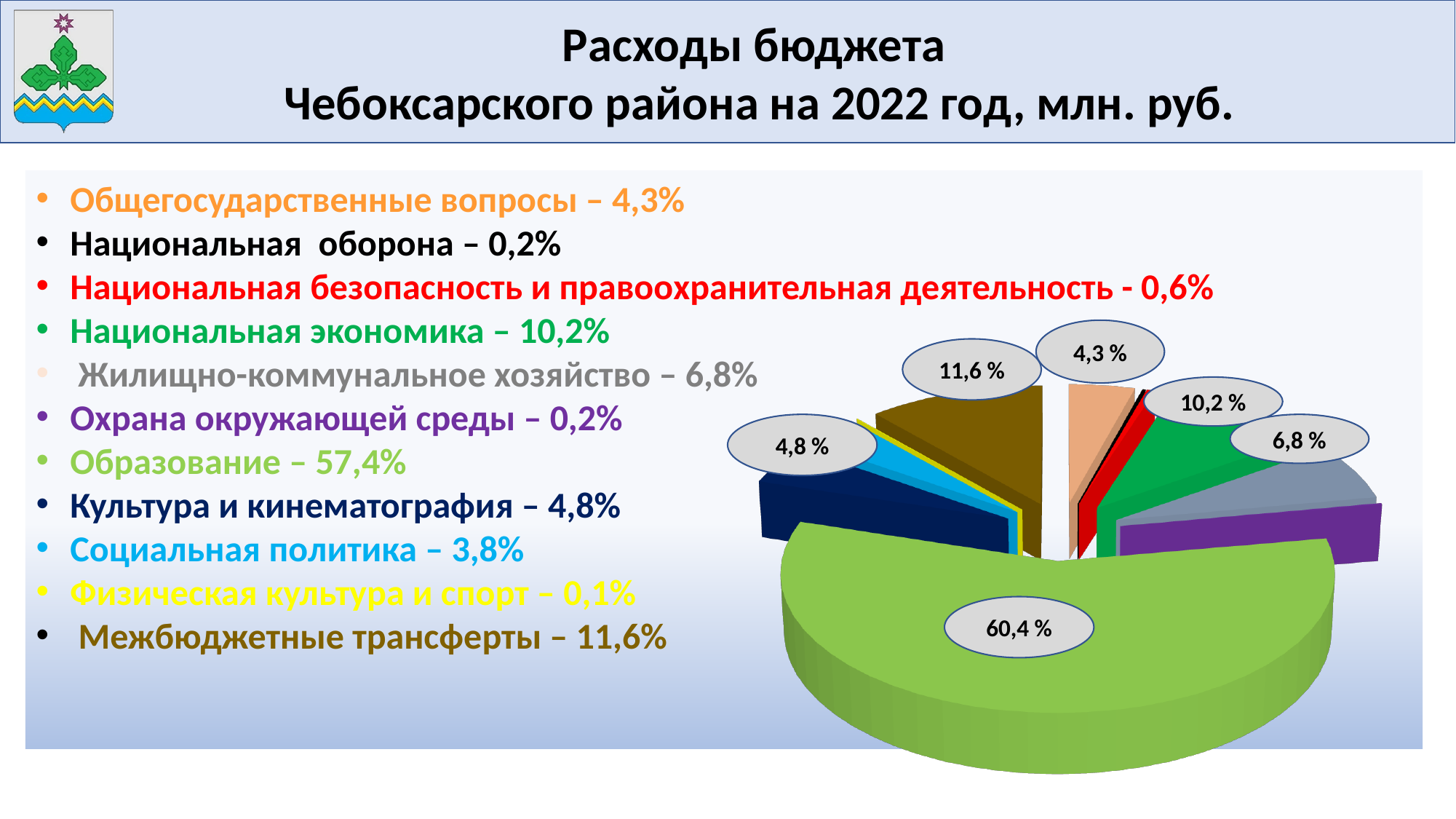
What is the title of the slide's chart? Расходы бюджета Чебоксарского района на 2022 год, млн. руб. What kind of chart is shown on the slide? pie chart What percentage is printed on the dark navy slice of the pie chart? 4,8 % Which labelled value on the pie chart is the smallest? 4,3 % Which is larger on the pie chart: the brown slice or the dark green slice? the brown slice (11,6 %) What percentage is printed on the grey slice of the pie chart? 6,8 % What percentage is printed on the brown slice of the pie chart? 11,6 % How many slices of the pie chart have a percentage label? 6 Which labelled value on the pie chart is the largest? 60,4 % What is the difference between the 11,6 % slice and the 4,3 % slice on the pie chart? 7,3 % What percentage is printed on the dark green slice of the pie chart? 10,2 % What percentage is printed on the largest (light green) slice of the pie chart? 60,4 %